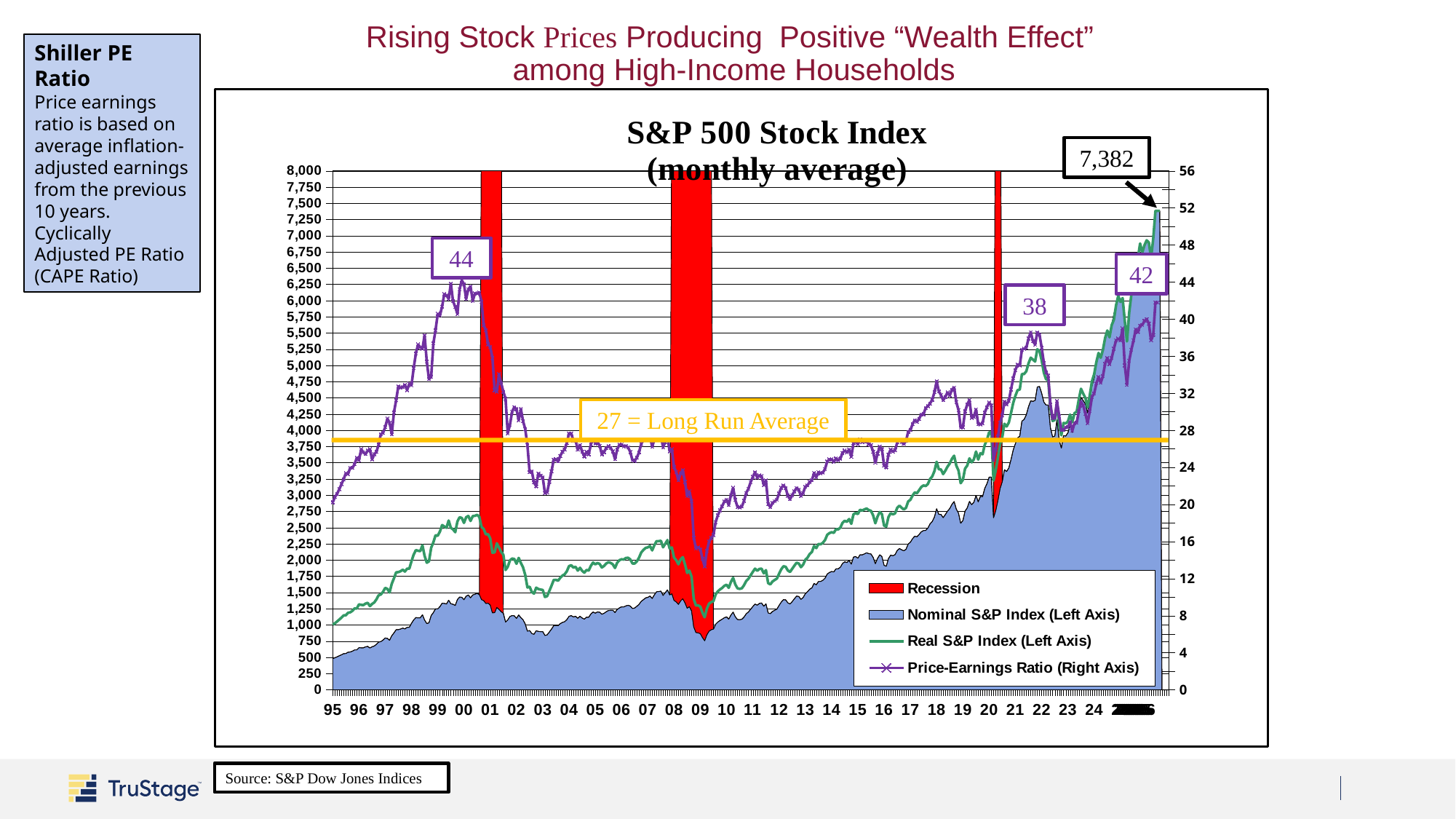
What is the title of the chart? S&P 500 Stock Index (monthly average) Overall, does the Nominal S&P Index rise or fall from 1995 to the end of the chart? rise What is the latest value of the Nominal S&P Index labeled on the chart? 7,382 How many series does the chart's legend list? 4 What is the most recent Price-Earnings Ratio value labeled on the chart? 42 Is the Nominal S&P Index at its 2009 low greater or less than 1,000? less What is the difference between the labeled Price-Earnings Ratio peak of 44 and the labeled peak of 38? 6 How many recession periods are shaded on the chart? 3 Which labeled Price-Earnings Ratio peak is larger, the one around 2000 or the one around 2021? The one around 2000 (44) What Price-Earnings Ratio value is labeled at the peak around 2000? 44 What Price-Earnings Ratio value is labeled at the peak around 2021? 38 What is the long run average of the Price-Earnings Ratio shown on the chart? 27